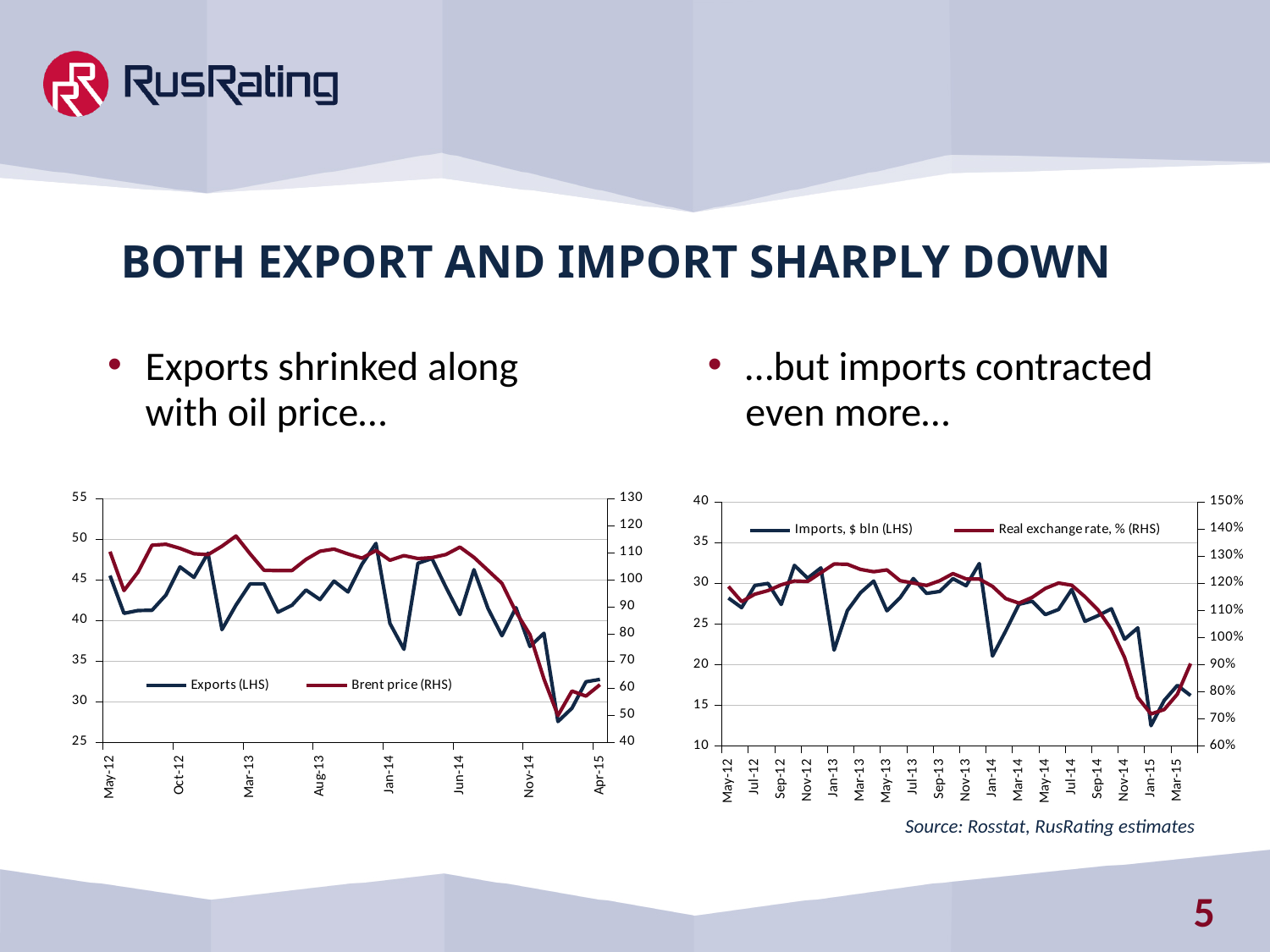
What kind of chart is the left chart (Exports and Brent price)? line chart What kind of chart is the right chart (Imports and Real exchange rate)? line chart In the right chart, is the value for Real exchange rate, % (RHS) at Jan-13 greater or less than 110%? greater How many series does the legend of the left chart list? 2 In the right chart, is the value for Imports, $ bln (LHS) at Jan-13 greater or less than 25? less In the left chart, is the value for Brent price (RHS) at Mar-13 greater or less than 100? greater In the left chart, does the Brent price (RHS) rise or fall between Jun-14 and Jan-15? fall In the right chart, does the Imports, $ bln (LHS) series rise or fall between Jul-14 and Jan-15? fall What are the two series named in the legend of the right chart? Imports, $ bln (LHS) and Real exchange rate, % (RHS)